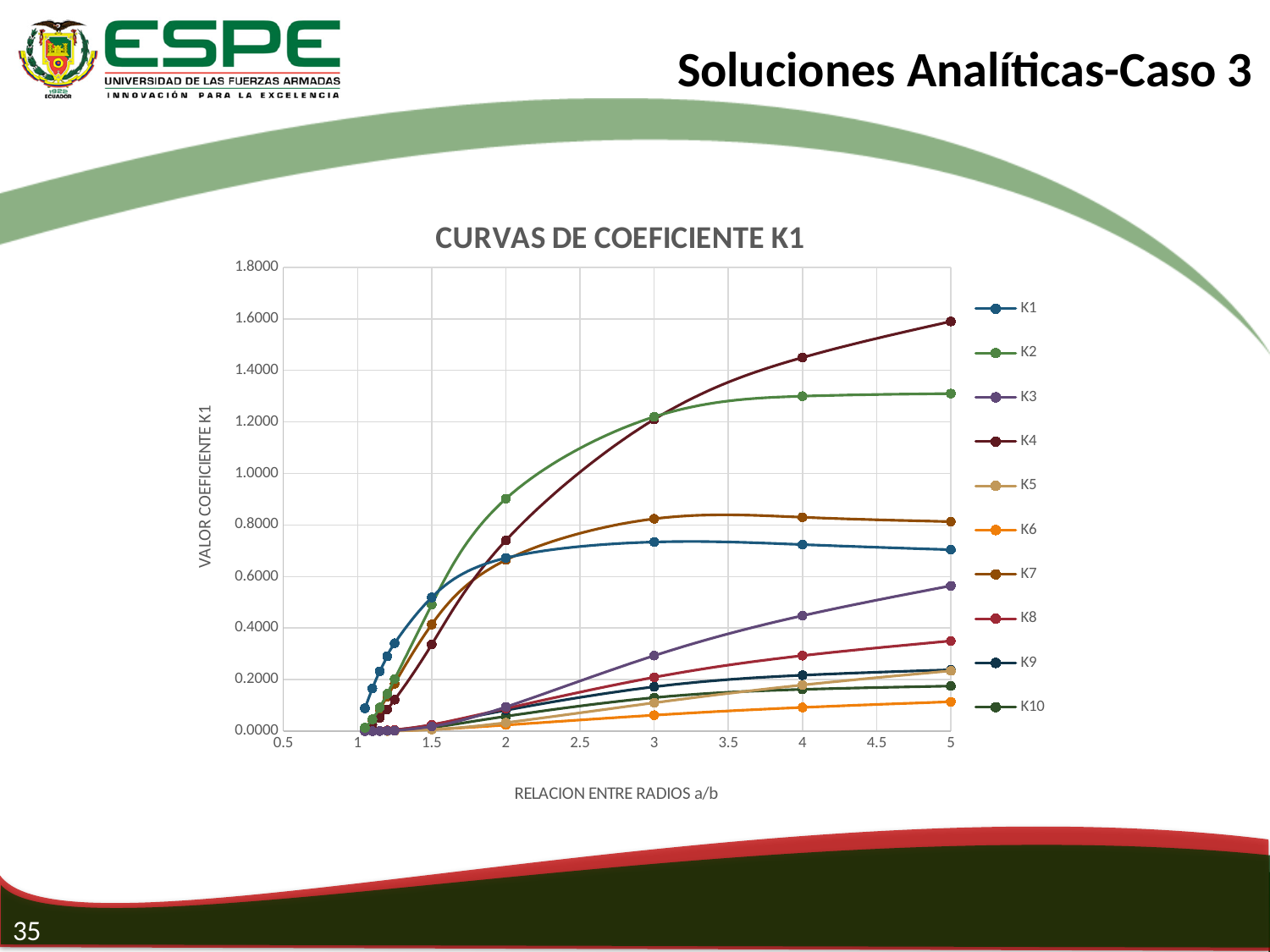
How many series does the legend list? 10 Does the K4 series rise or fall as a/b increases from 1 to 5? rise Is the value of K1 at a/b = 5 greater or less than 0.8000? less At a/b = 5, which is larger, K2 or K7? K2 Is the value of K4 at a/b = 5 greater or less than 1.4000? greater Which series has the lowest value at a/b = 5? K6 Which series has the highest value at a/b = 5? K4 Is the value of K3 at a/b = 3 greater or less than 0.4000? less What is the title of the chart? CURVAS DE COEFICIENTE K1 What is the label of the x axis? RELACION ENTRE RADIOS a/b What kind of chart is shown on the slide? line chart